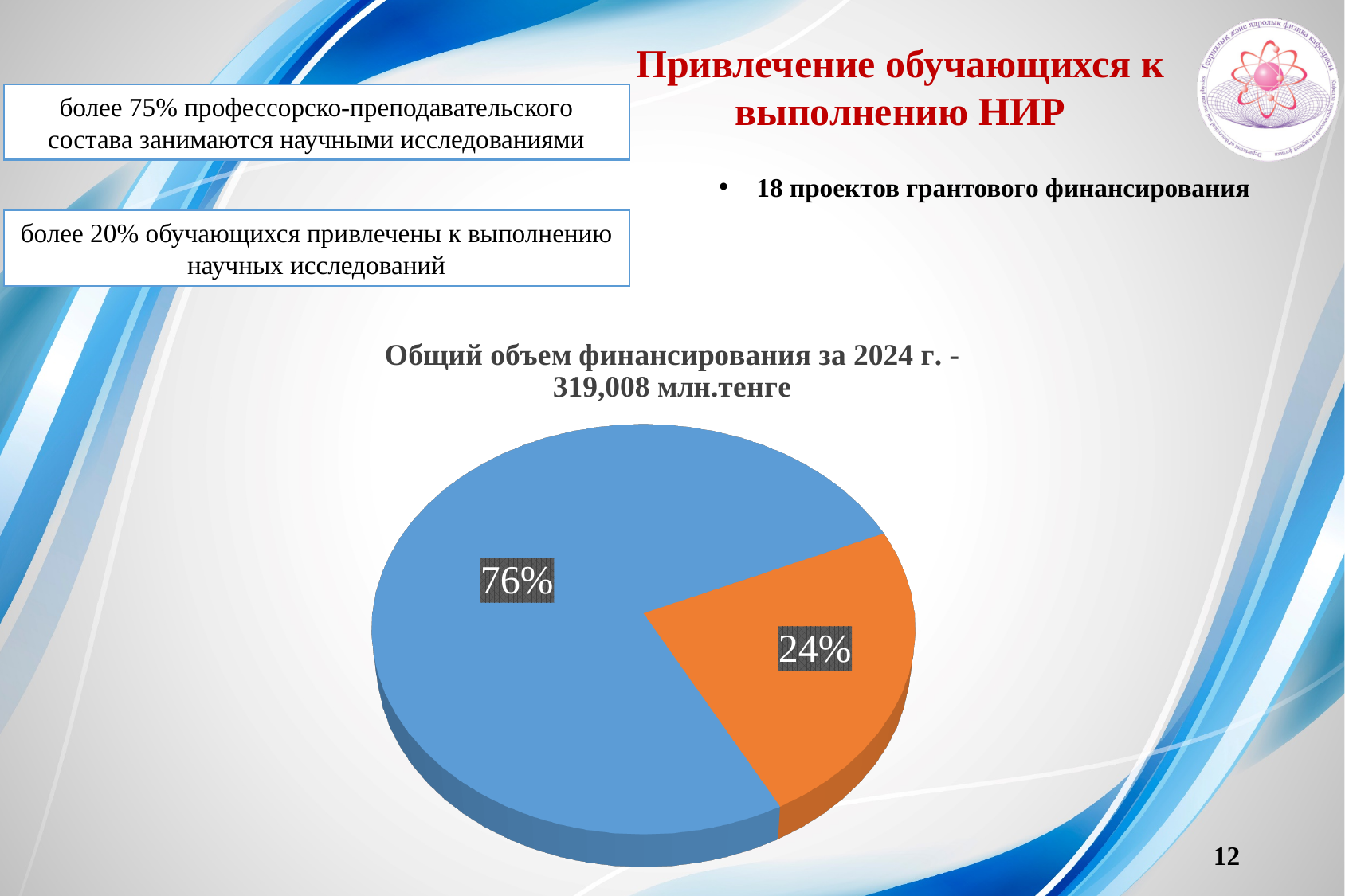
What kind of chart is shown on the slide? pie chart What share of the pie does the blue slice represent? 76% How many slices does the pie chart have? 2 Which slice of the pie chart is the smallest? the orange slice (24%) What share of the pie does the orange slice represent? 24% By how many percentage points does the blue slice exceed the orange slice? 52 percentage points What is the title of the pie chart? Общий объем финансирования за 2024 г. - 319,008 млн.тенге Is the share of the orange slice greater or less than 50%? less What total funding amount for 2024 is stated in the chart title? 319,008 млн.тенге Which is larger, the blue slice or the orange slice? the blue slice Which slice of the pie chart is the largest? the blue slice (76%)